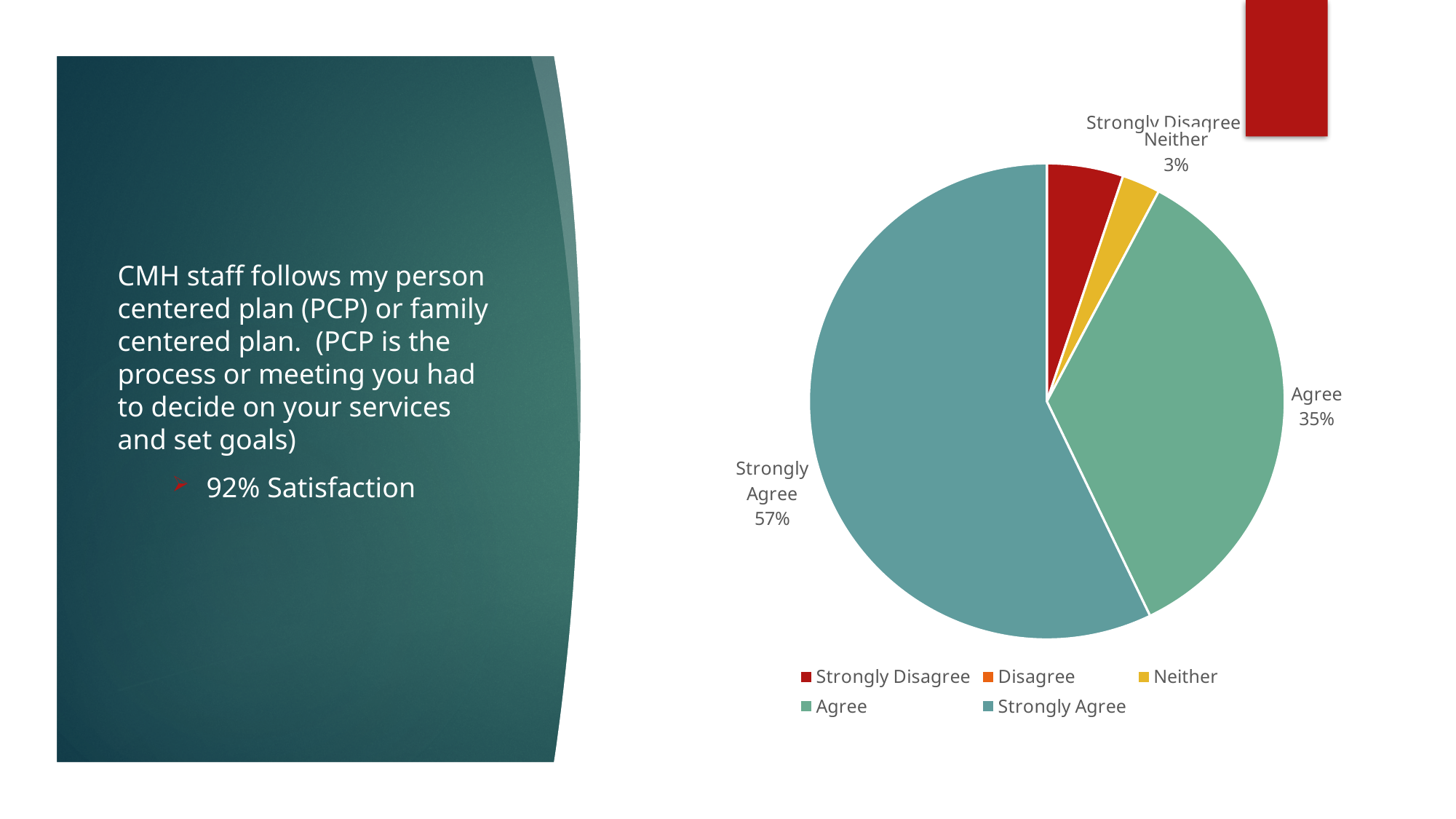
What is the difference in percentage points between the Strongly Agree and Agree slices? 22% What kind of chart is shown on the slide? pie chart What percentage of the pie is labelled Strongly Agree? 57% What is the difference in percentage points between the Agree and Neither slices? 32% What percentage of the pie is labelled Agree? 35% Which slice is larger, Neither or Agree? Agree Which slice is larger, Agree or Strongly Agree? Strongly Agree What colour represents Neither in the pie chart? yellow Which response category has the largest slice of the pie? Strongly Agree What percentage of the pie is labelled Neither? 3% What colour represents Strongly Disagree in the pie chart legend? red How many categories does the legend of the pie chart list? 5